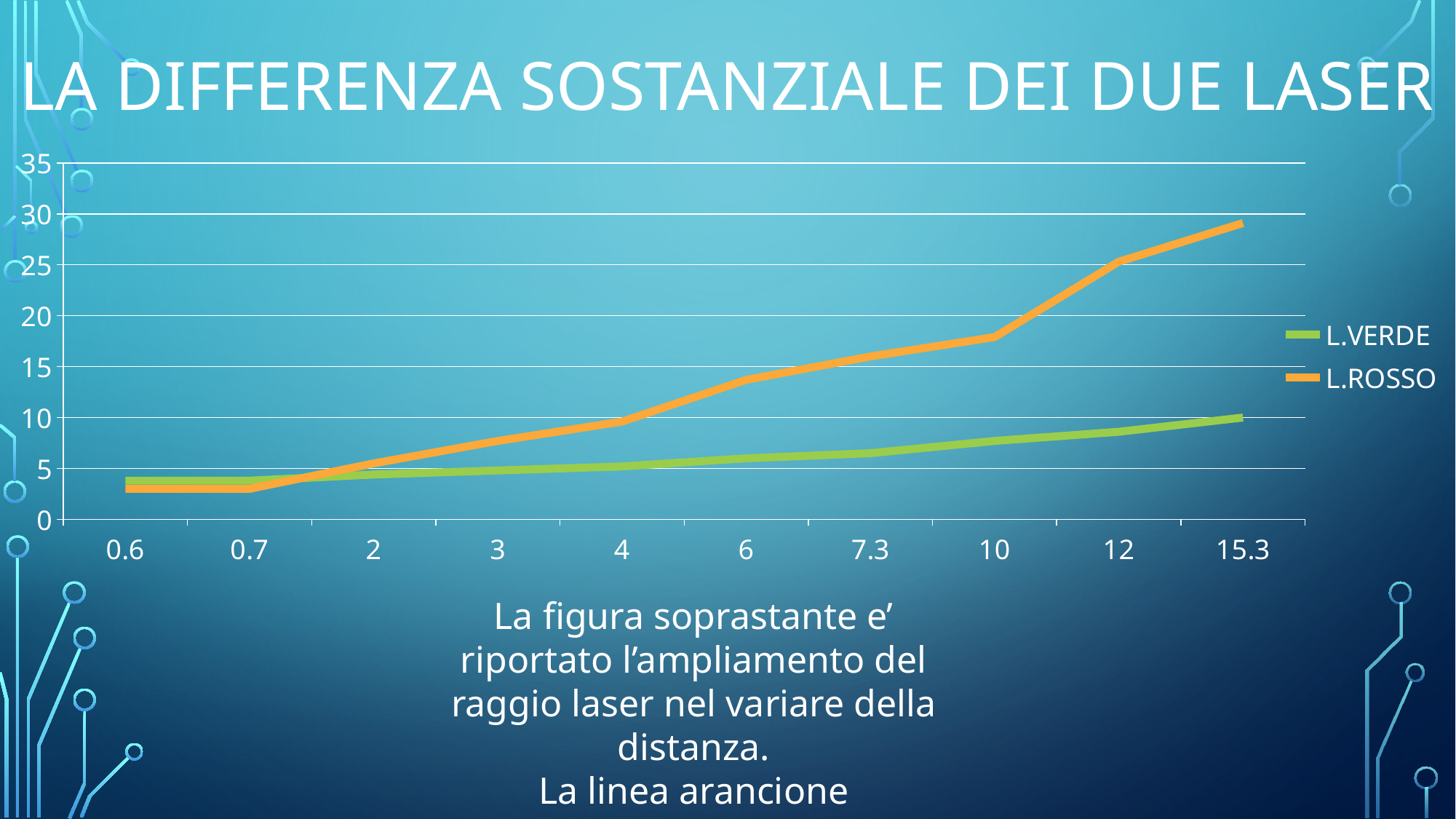
Is the value of L.ROSSO at 0.6 greater or less than 5? less Is the value of L.ROSSO at 10 greater or less than 15? greater At which x-axis category does L.ROSSO reach its highest value? 15.3 How many points are plotted along the x axis for each series? 10 Do the values of L.ROSSO rise or fall along the x axis? rise How many series does the legend list? 2 Is the value of L.VERDE at 10 greater or less than 10? less At 15.3, which series has the higher value, L.VERDE or L.ROSSO? L.ROSSO What kind of chart is shown on the slide? line chart